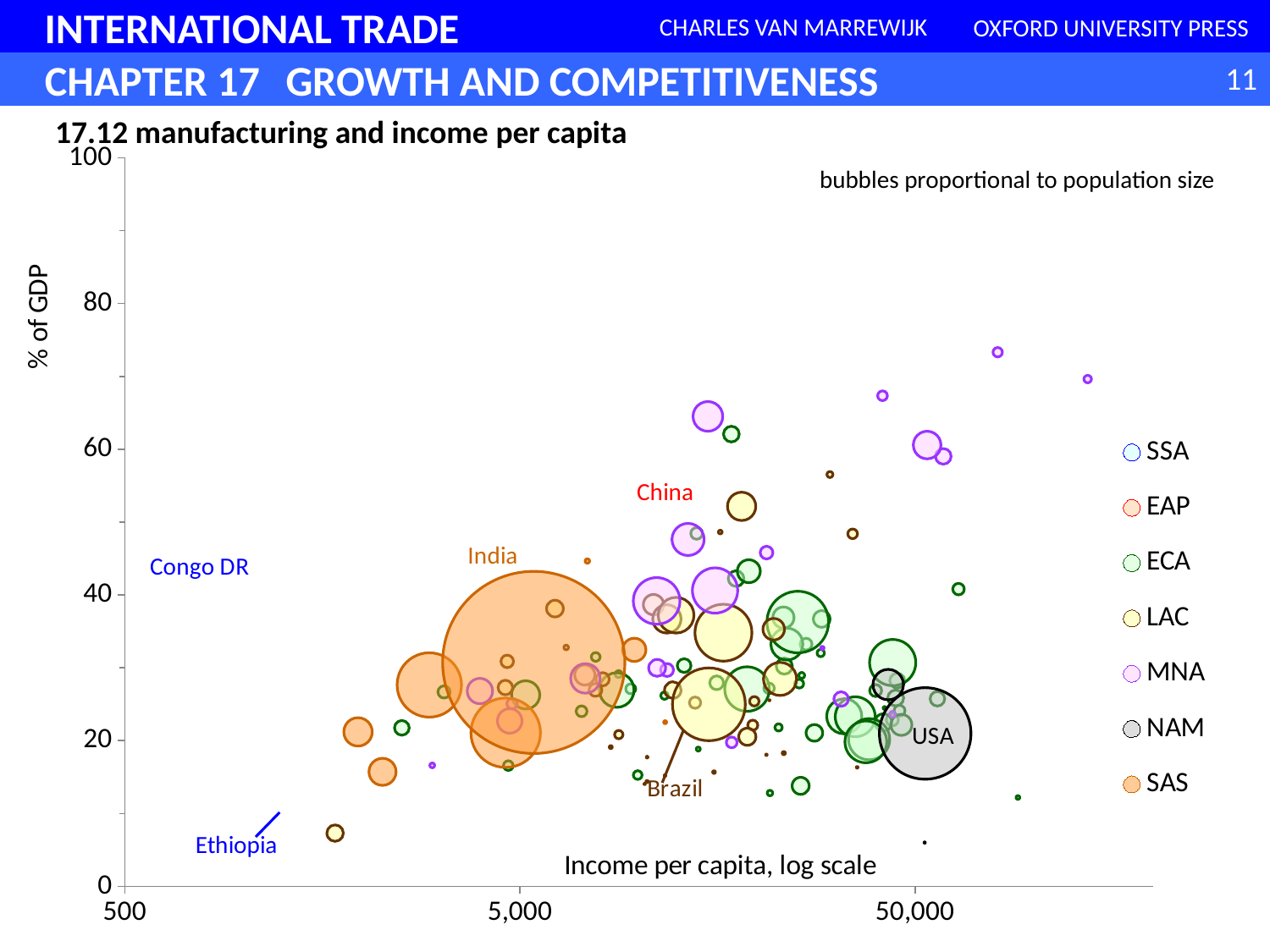
Is the value for Brazil on the % of GDP axis greater or less than 40? less How many series does the legend list? 7 Which labeled country has the highest income per capita? USA Is the value for India on the % of GDP axis greater or less than 20? greater What kind of chart is shown on the slide? bubble chart Which labeled country has the largest bubble? India Is the value for USA on the income per capita axis greater or less than 5,000? greater What does the bubble size represent, according to the note on the chart? population size Which has a higher % of GDP, India or USA? India What is the title of the chart? 17.12 manufacturing and income per capita